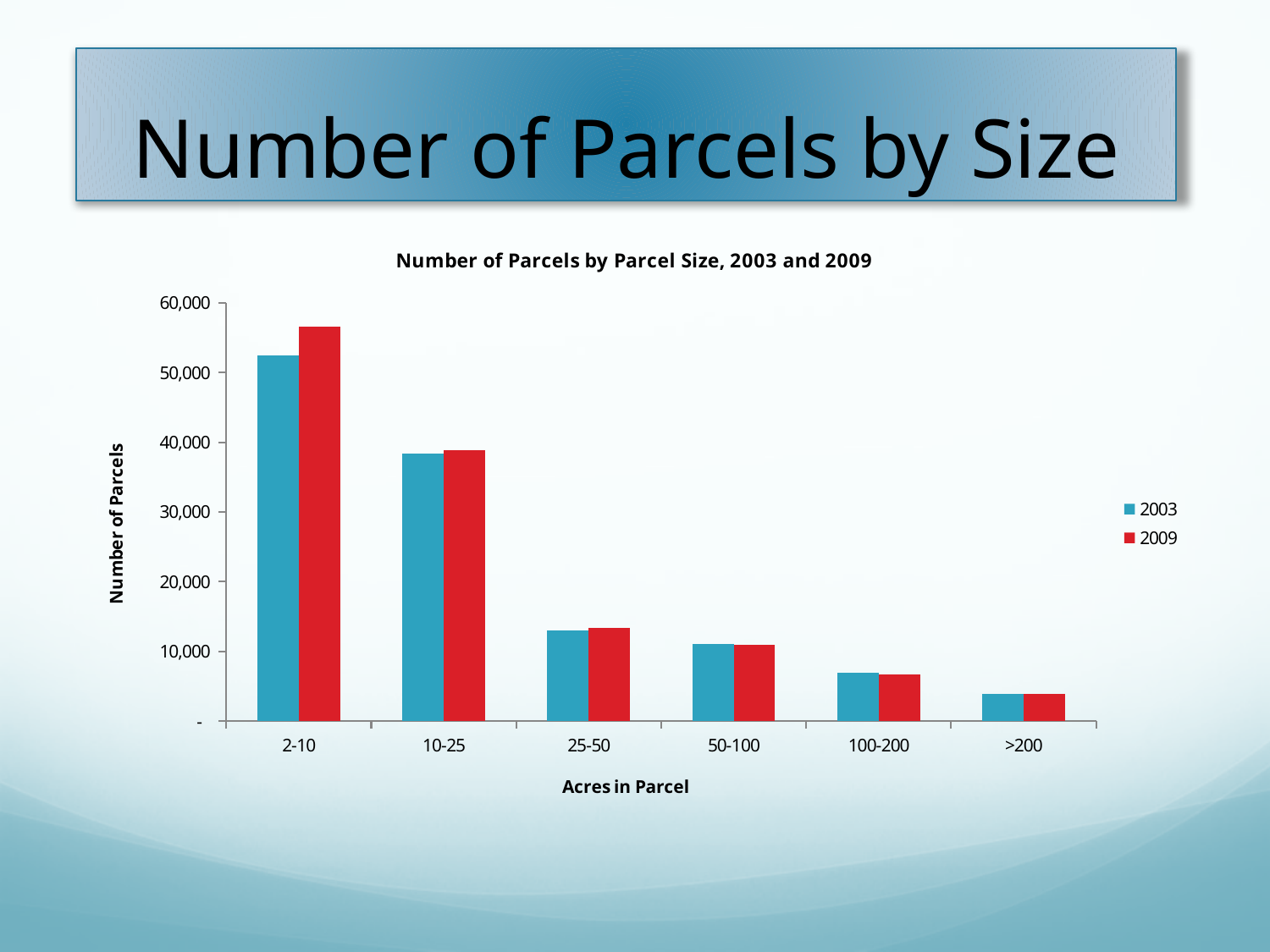
What is the title of the chart? Number of Parcels by Parcel Size, 2003 and 2009 Which parcel size category has the lowest number of parcels in 2003? >200 Do the number of parcels rise or fall as parcel size increases along the x axis? Fall How many parcel size categories are shown on the x axis? 6 What kind of chart is shown on the slide? Bar chart Is the 2009 value for the 100-200 acre category greater or less than 10,000? less Which parcel size category has the highest number of parcels in 2009? 2-10 Is the 2003 value for the 10-25 acre category greater or less than 40,000? less Is the 2003 value for the 2-10 acre category greater or less than 50,000? greater For the 2-10 acre category, which year has the larger number of parcels, 2003 or 2009? 2009 How many series does the legend list? 2